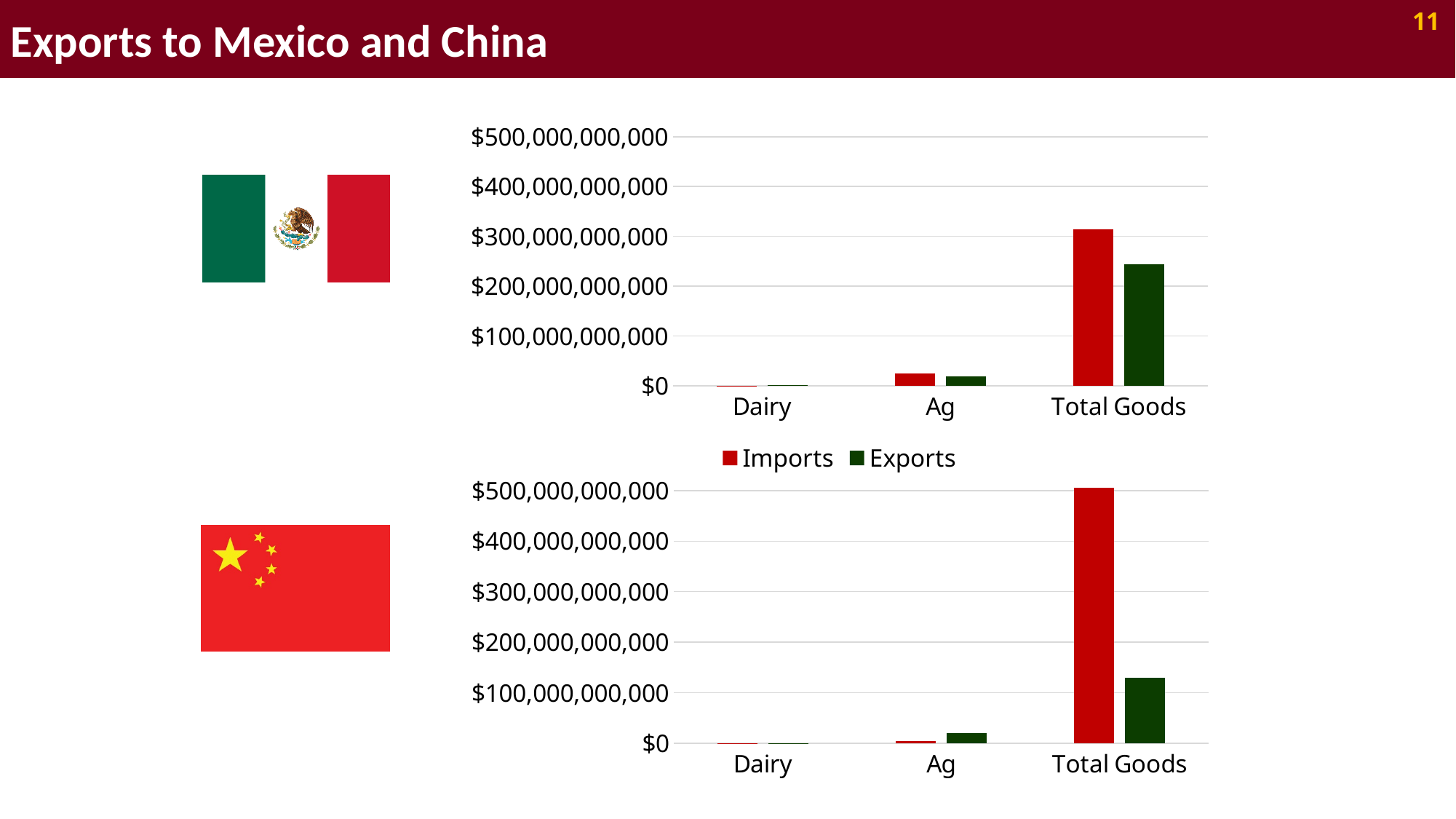
In the bottom chart next to the Chinese flag, which category has the lowest Exports value? Dairy What kind of chart is the top chart next to the Mexican flag? bar chart In the bottom chart next to the Chinese flag, is the Imports value for Total Goods greater or less than $400,000,000,000? greater In the top chart next to the Mexican flag, is the Imports value for Total Goods greater or less than $300,000,000,000? greater In the top chart next to the Mexican flag, is the Exports value for Total Goods greater or less than $300,000,000,000? less How many categories are shown on the x axis of the bottom chart next to the Chinese flag? 3 How many series does the legend list? 2 In the bottom chart next to the Chinese flag, which is larger for Ag: Imports or Exports? Exports In the top chart next to the Mexican flag, which is larger for Total Goods: Imports or Exports? Imports In the top chart next to the Mexican flag, which category has the highest Imports value? Total Goods What colour are the Exports bars in the charts? dark green